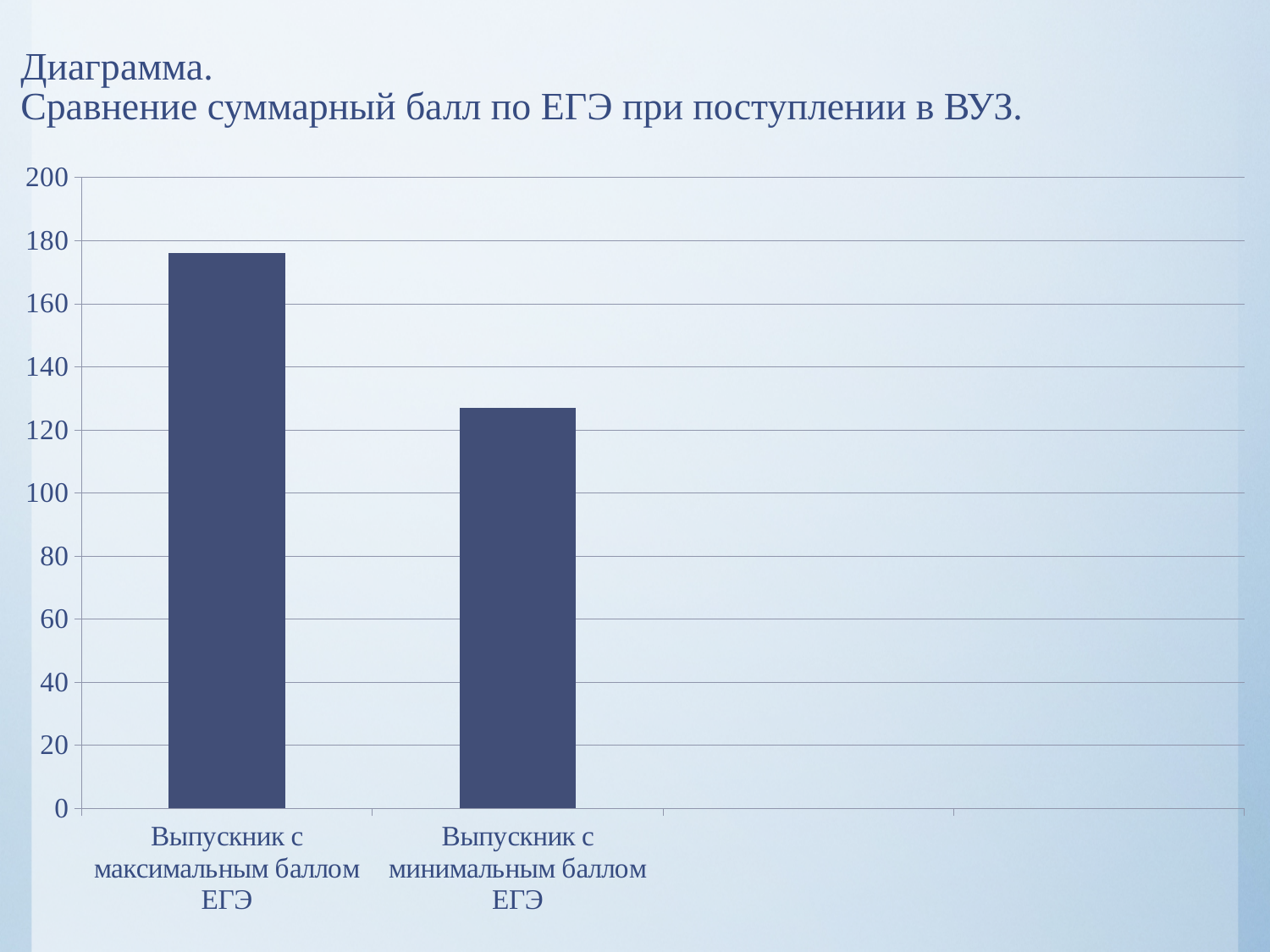
Is the value for 'Выпускник с максимальным баллом ЕГЭ' greater or less than 180? less How many categories are plotted in the chart? 2 Which category has the highest value? Выпускник с максимальным баллом ЕГЭ What is the title of the slide above the chart? Диаграмма. Сравнение суммарный балл по ЕГЭ при поступлении в ВУЗ. Is the value for 'Выпускник с минимальным баллом ЕГЭ' greater or less than 120? greater What kind of chart is shown on the slide? bar chart Which category has the lowest value? Выпускник с минимальным баллом ЕГЭ Is the value for 'Выпускник с максимальным баллом ЕГЭ' greater or less than 160? greater Do the values rise or fall from left to right along the x axis? fall What is the maximum value shown on the vertical axis? 200 Which is larger: the value for 'Выпускник с максимальным баллом ЕГЭ' or the value for 'Выпускник с минимальным баллом ЕГЭ'? Выпускник с максимальным баллом ЕГЭ